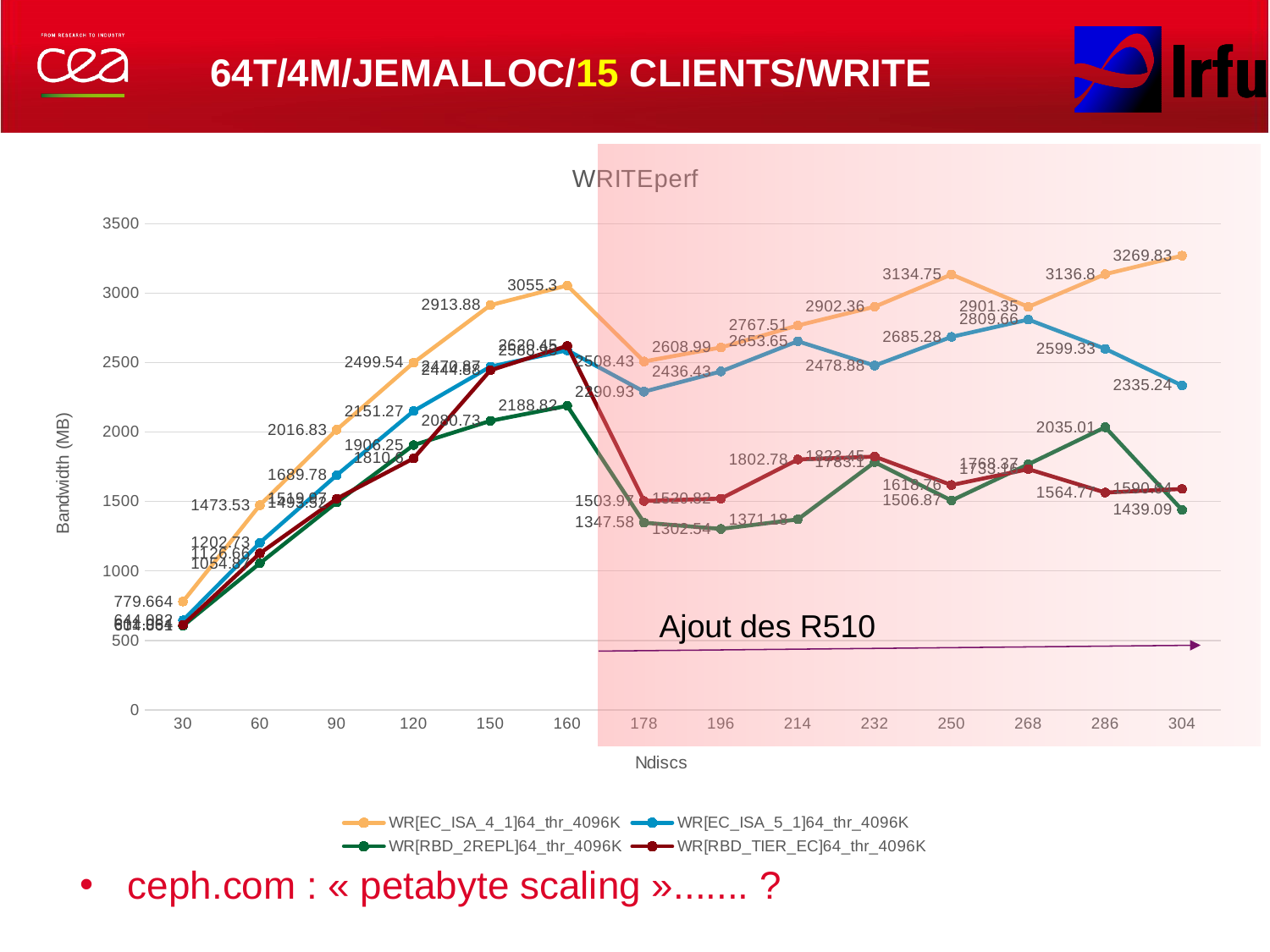
What is the value of WR[EC_ISA_4_1]64_thr_4096K at 160 Ndiscs? 3055.3 For WR[EC_ISA_4_1]64_thr_4096K, is the value higher at 250 or at 268 Ndiscs? 250 What is the value of WR[EC_ISA_5_1]64_thr_4096K at 304 Ndiscs? 2335.24 Is the value for WR[RBD_2REPL]64_thr_4096K at 196 Ndiscs greater or less than 1500? less What is the value of WR[EC_ISA_4_1]64_thr_4096K at 304 Ndiscs? 3269.83 What is the difference between WR[EC_ISA_4_1]64_thr_4096K and WR[EC_ISA_5_1]64_thr_4096K at 304 Ndiscs? 934.59 What is the value of WR[RBD_2REPL]64_thr_4096K at 286 Ndiscs? 2035.01 Which series has the lowest value at 304 Ndiscs? WR[RBD_2REPL]64_thr_4096K What kind of chart is shown on the slide? line chart How many Ndiscs values are shown on the x axis of the WRITEperf chart? 14 Which series has the highest value at 304 Ndiscs? WR[EC_ISA_4_1]64_thr_4096K How many series does the legend of the WRITEperf chart list? 4